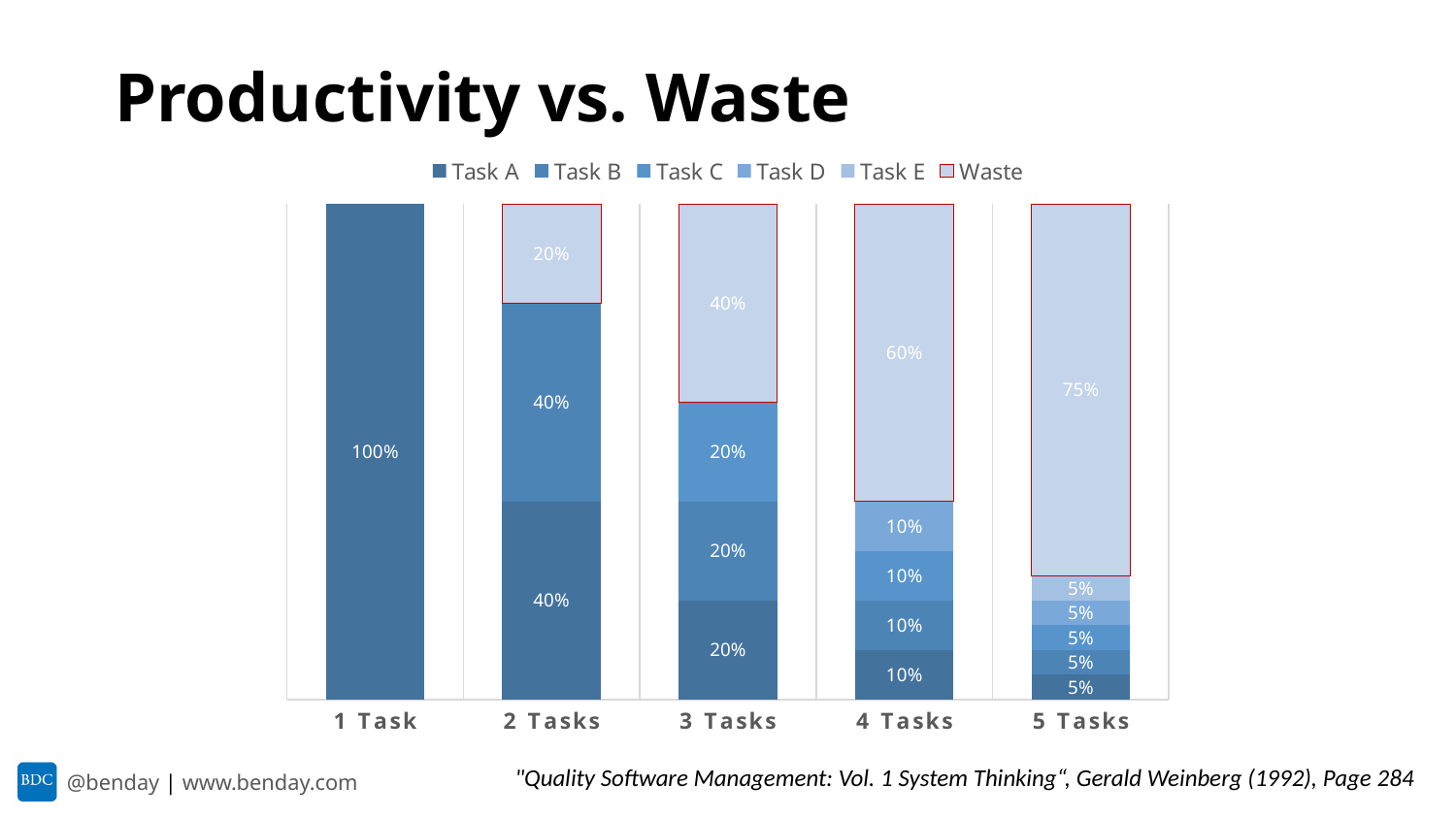
Which category has the largest Waste segment? 5 Tasks What is the difference between the Waste value for 5 Tasks and the Waste value for 4 Tasks? 15% What is the value for Task B in the 2 Tasks bar? 40% How many categories are shown on the x axis? 5 What kind of chart is shown on the slide? Stacked bar chart What is the Waste value for 5 Tasks? 75% Which has a larger Waste value, 2 Tasks or 3 Tasks? 3 Tasks What is the title of the chart? Productivity vs. Waste What is the value for Task A in the 1 Task bar? 100% How many series does the legend list? 6 Does the Waste value rise or fall as the number of tasks increases from 2 Tasks to 5 Tasks? Rise What is the Waste value for 3 Tasks? 40%